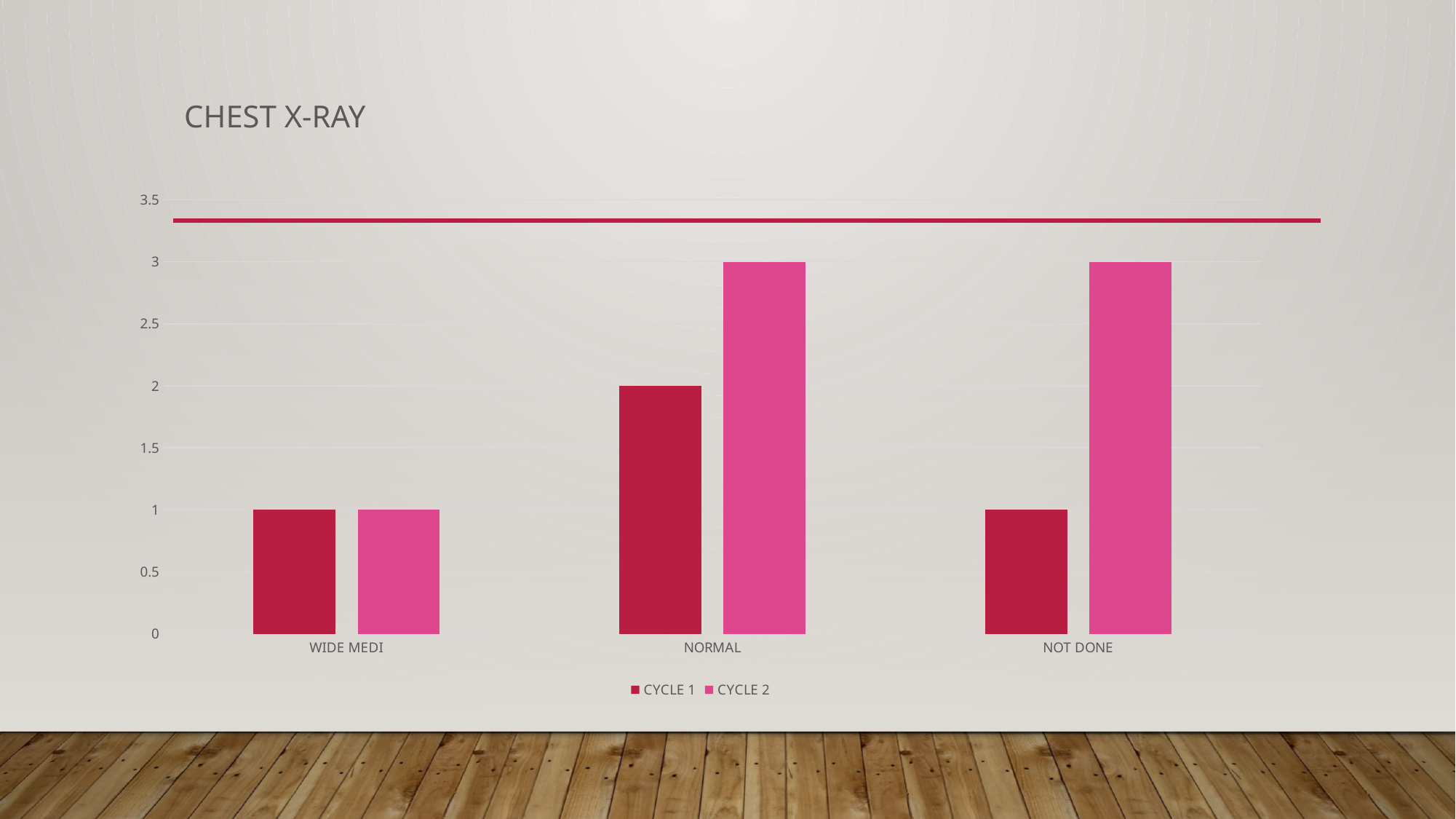
Which category has the highest CYCLE 1 value? NORMAL What kind of chart is shown on the slide? bar chart What is the CYCLE 2 value for NOT DONE? 3 For NORMAL, which is larger, CYCLE 1 or CYCLE 2? CYCLE 2 What is the difference between the CYCLE 2 and CYCLE 1 values for NOT DONE? 2 Which category has the lowest CYCLE 2 value? WIDE MEDI What is the CYCLE 1 value for NORMAL? 2 What is the title of the chart? CHEST X-RAY How many categories are shown on the x axis? 3 Is the CYCLE 2 value for NORMAL greater or less than 2.5? greater How many series does the legend list? 2 What is the CYCLE 1 value for WIDE MEDI? 1